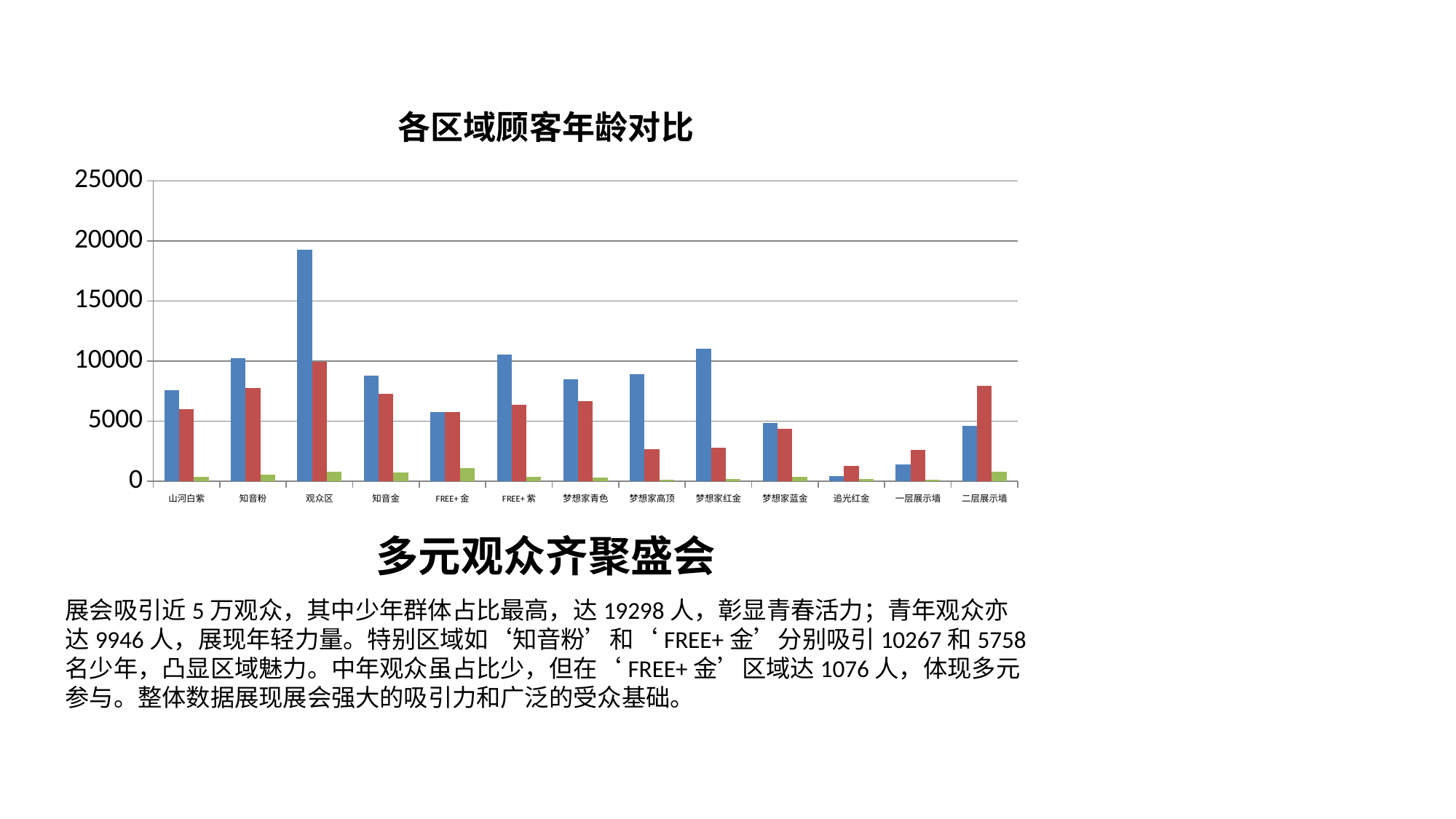
Is the red bar for 追光红金 greater or less than 5000? less How many bars are plotted for each category in the chart? 3 What is the title of the chart? 各区域顾客年龄对比 Is the blue bar for 观众区 greater or less than 15000? greater How many categories are shown on the x axis of the chart? 13 For 梦想家红金, which bar is taller, the blue bar or the red bar? the blue bar Which category has the tallest red bar in the chart? 观众区 What kind of chart is shown on the slide? bar chart Which category has the tallest blue bar in the chart? 观众区 For 二层展示墙, which bar is taller, the blue bar or the red bar? the red bar Which category has the tallest green bar in the chart? FREE+ 金